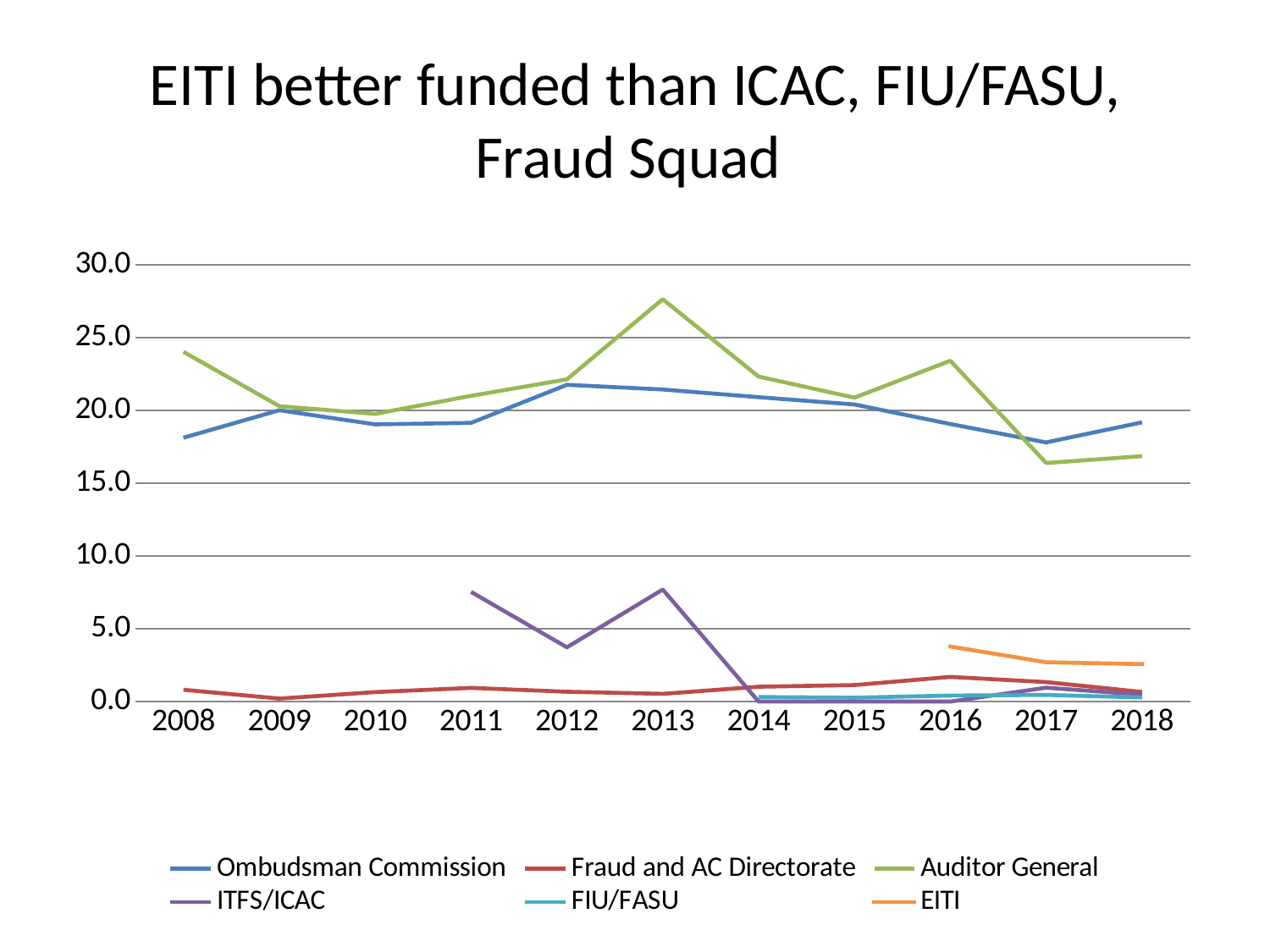
Does the Auditor General line rise or fall from 2016 to 2017? fall Which series has the highest value in 2013? Auditor General Is the value for EITI in 2016 greater or less than 5.0? less In which year does the EITI line first appear on the chart? 2016 In 2008, which is larger: Ombudsman Commission or Auditor General? Auditor General How many series does the legend list? 6 How many years are shown along the x axis? 11 What kind of chart is shown on the slide? line chart Is the value for Ombudsman Commission in 2008 greater or less than 20.0? less Is the value for ITFS/ICAC in 2011 greater or less than 5.0? greater Which series has the highest value in 2017? Ombudsman Commission